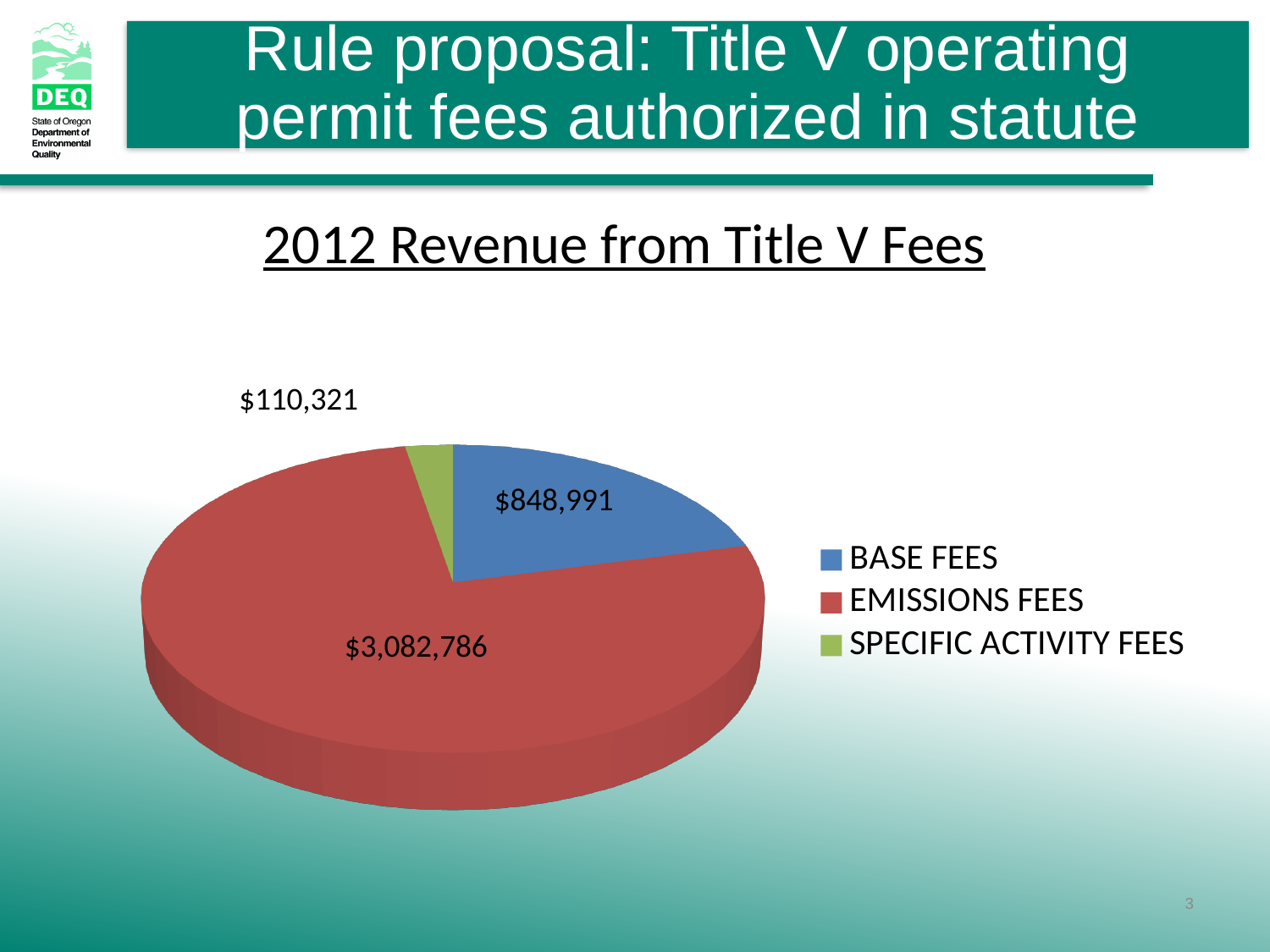
Which fee category has the smallest revenue? SPECIFIC ACTIVITY FEES What is the title of the chart? 2012 Revenue from Title V Fees What is the revenue value for BASE FEES? $848,991 What type of chart is shown on the slide? Pie chart What is the revenue value for EMISSIONS FEES? $3,082,786 What is the difference between BASE FEES and SPECIFIC ACTIVITY FEES revenue? $738,670 What is the difference between EMISSIONS FEES and BASE FEES revenue? $2,233,795 Which is larger, BASE FEES or SPECIFIC ACTIVITY FEES? BASE FEES What is the revenue value for SPECIFIC ACTIVITY FEES? $110,321 Which fee category has the largest revenue? EMISSIONS FEES How many categories does the legend list? 3 What colour represents EMISSIONS FEES in the chart? Red